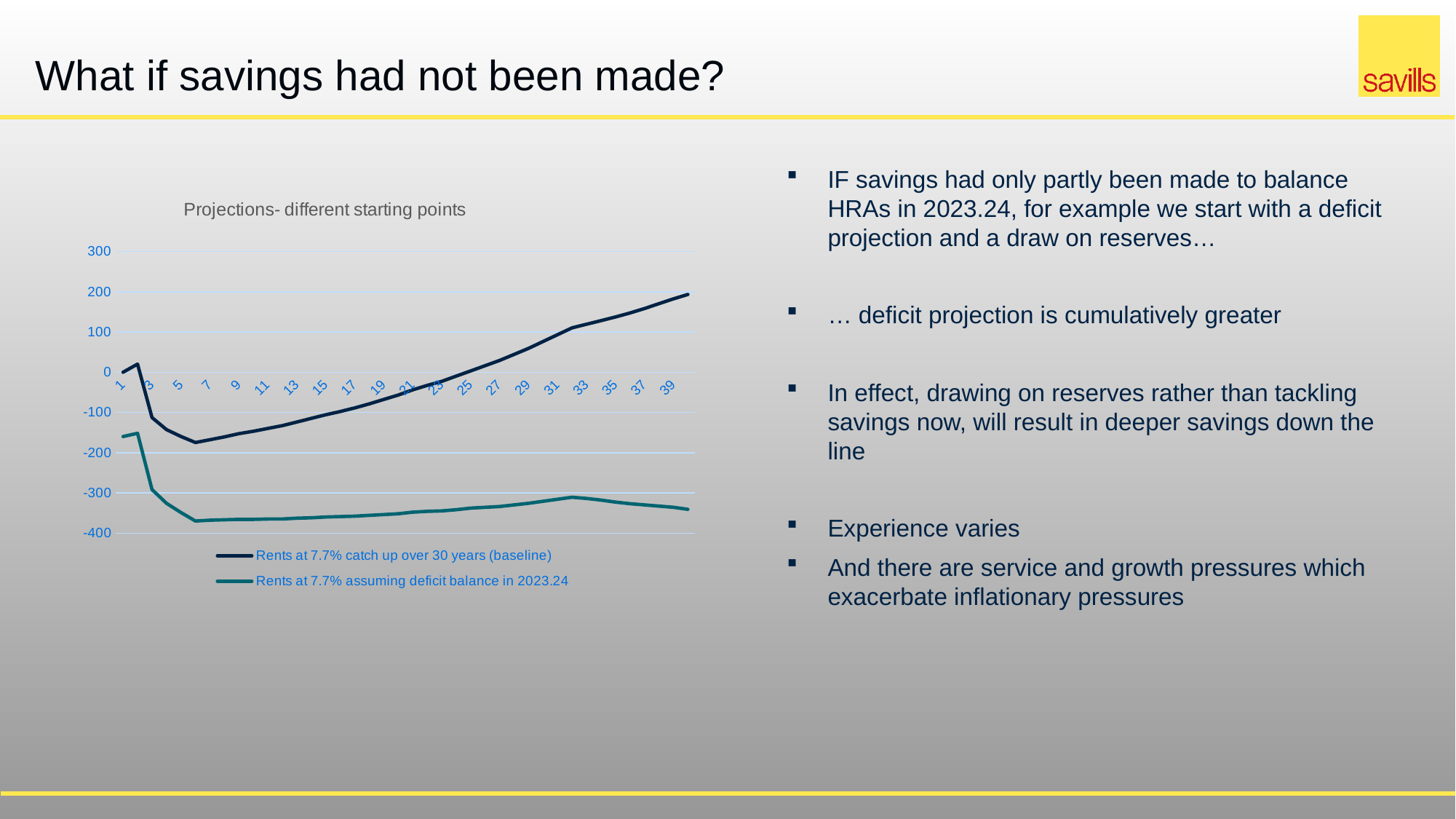
What is the title of the chart? Projections- different starting points Which series stays lower across the whole x axis? Rents at 7.7% assuming deficit balance in 2023.24 How many series does the legend list? 2 Which series is drawn in the teal (lighter) line? Rents at 7.7% assuming deficit balance in 2023.24 How many x-axis labels are shown on the chart? 20 Is the value of the 'Rents at 7.7% assuming deficit balance in 2023.24' series at point 39 greater or less than -300? less Is the value of the 'Rents at 7.7% catch up over 30 years (baseline)' series at point 39 greater or less than 100? greater Is the value of the 'Rents at 7.7% catch up over 30 years (baseline)' series at point 5 greater or less than -100? less Does the 'Rents at 7.7% catch up over 30 years (baseline)' series rise or fall from point 5 to point 39? rise At point 39, which series has the higher value? Rents at 7.7% catch up over 30 years (baseline) What kind of chart is shown on the slide? line chart